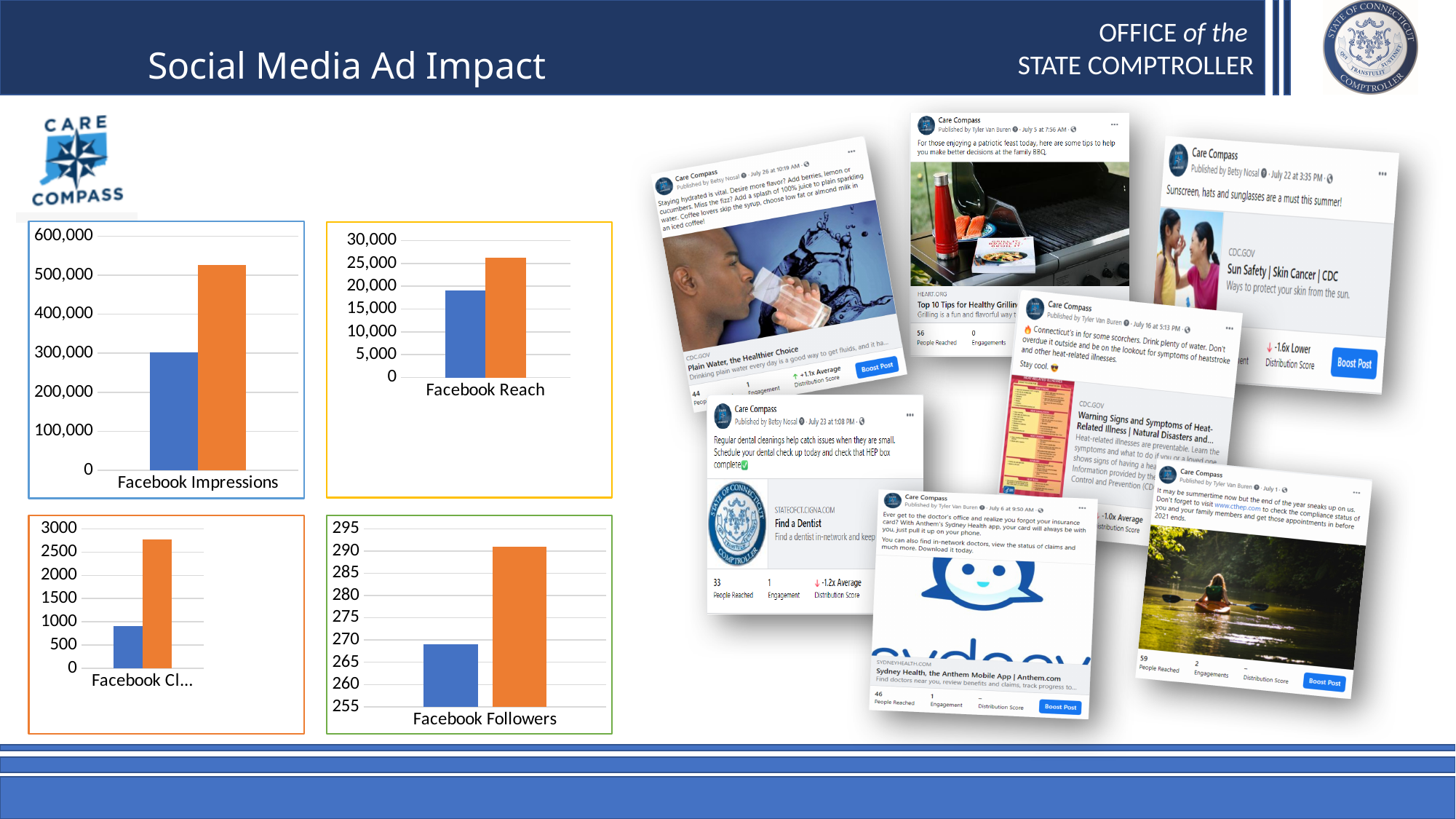
In the Facebook Impressions chart, is the value of the blue bar greater or less than 400,000? less In the Facebook Followers chart, is the value of the orange bar greater or less than 285? greater In the bottom-left chart (Facebook Cl...), is the value of the orange bar greater or less than 2500? greater How many charts are shown on the slide? 4 What kind of chart is the Facebook Impressions chart? bar chart In the Facebook Followers chart, which bar is shorter, the blue bar or the orange bar? the blue bar In the Facebook Impressions chart, which bar is taller, the blue bar or the orange bar? the orange bar How many bars are plotted in the Facebook Reach chart? 2